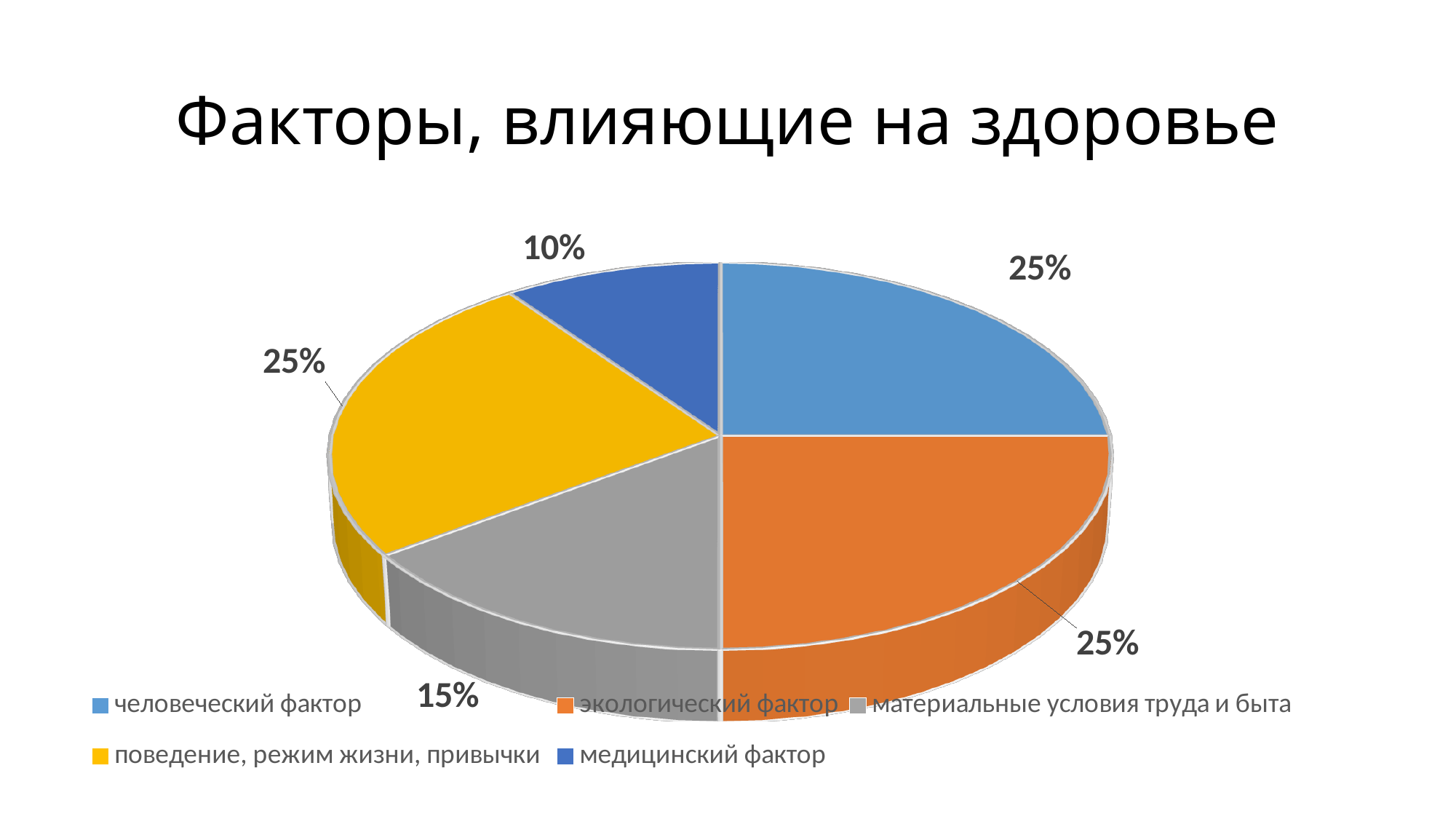
What share of the pie is поведение, режим жизни, привычки? 25% What kind of chart is shown on the slide? pie chart What share of the pie is материальные условия труда и быта? 15% Which is larger: материальные условия труда и быта or медицинский фактор? материальные условия труда и быта What colour is the slice for поведение, режим жизни, привычки? yellow How many slices does the pie chart have? 5 What share of the pie is медицинский фактор? 10% What is the title of the chart? Факторы, влияющие на здоровье Which category has the smallest slice? медицинский фактор What is the difference between the share for человеческий фактор and the share for медицинский фактор? 15%